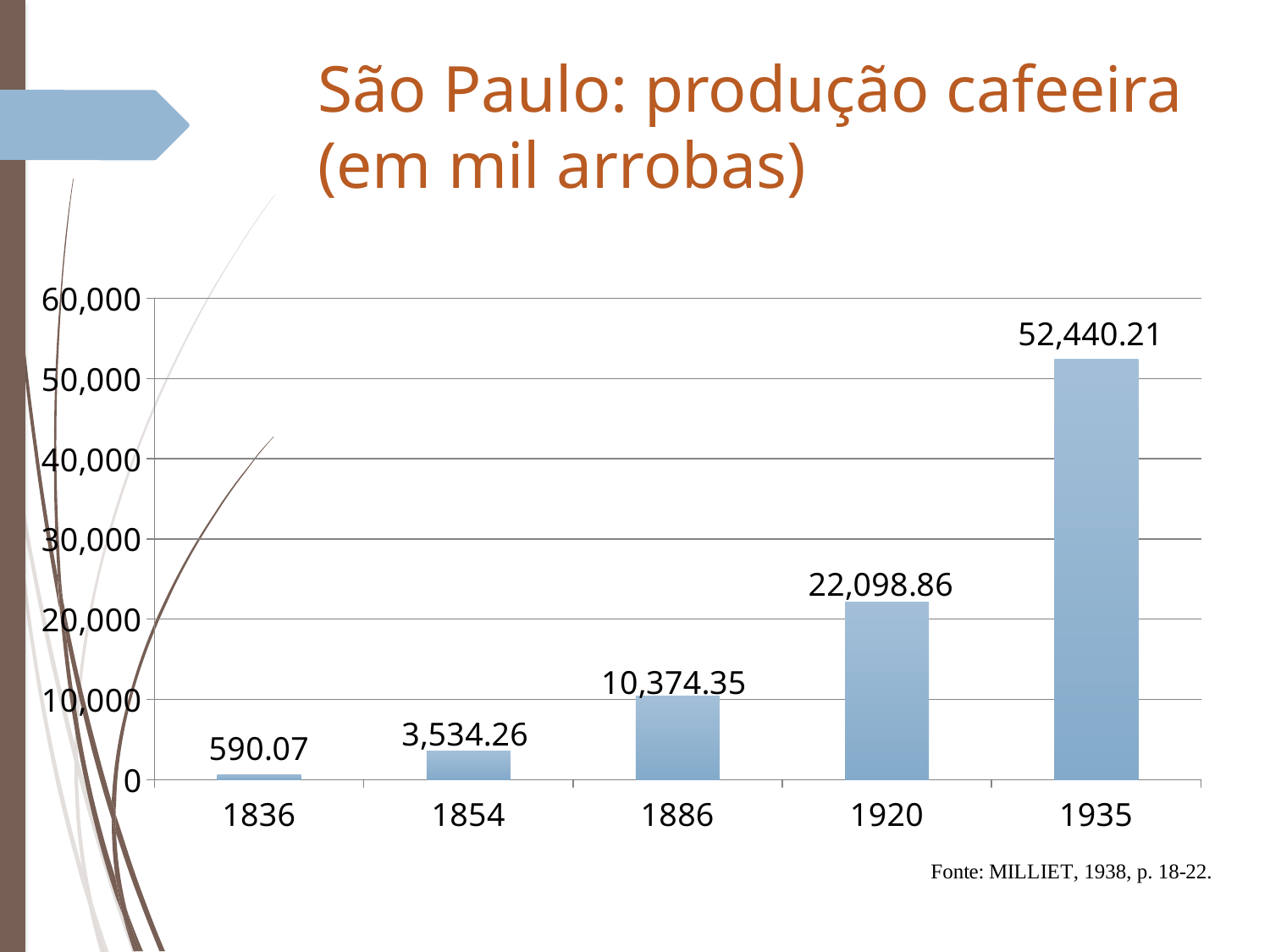
What kind of chart is shown on the slide? Bar chart What is the difference between the values for 1935 and 1920? 30,341.35 Which year has the highest value? 1935 What is the value for 1886? 10,374.35 What is the value for 1935? 52,440.21 Which is larger, the value for 1886 or the value for 1854? 1886 How many years are shown on the x axis? 5 What is the difference between the values for 1920 and 1886? 11,724.51 Which year has the lowest value? 1836 What is the value for 1836? 590.07 What is the value for 1920? 22,098.86 What is the value for 1854? 3,534.26